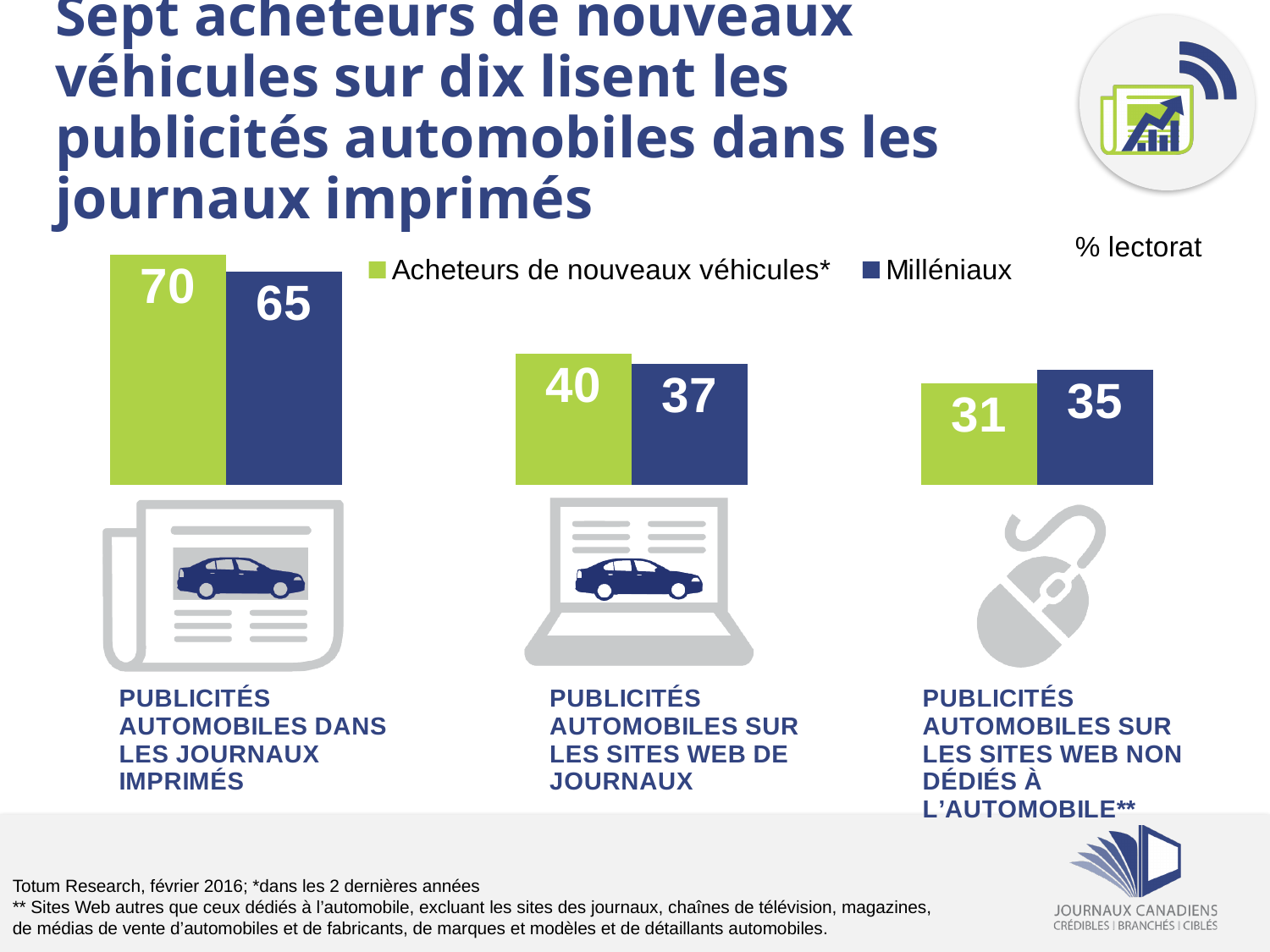
What unit label is shown above the chart? % lectorat How many categories are shown in the chart? 3 What is the difference between Milléniaux and Acheteurs de nouveaux véhicules for publicités automobiles sur les sites web non dédiés à l'automobile? 4 What is the value for Acheteurs de nouveaux véhicules for publicités automobiles dans les journaux imprimés? 70 What is the difference between Acheteurs de nouveaux véhicules and Milléniaux for publicités automobiles dans les journaux imprimés? 5 Which category has the lowest value for Acheteurs de nouveaux véhicules? Publicités automobiles sur les sites web non dédiés à l'automobile For publicités automobiles sur les sites web de journaux, which is larger: Acheteurs de nouveaux véhicules or Milléniaux? Acheteurs de nouveaux véhicules Which category has the highest value for Milléniaux? Publicités automobiles dans les journaux imprimés What is the value for Acheteurs de nouveaux véhicules for publicités automobiles sur les sites web non dédiés à l'automobile? 31 What is the value for Milléniaux for publicités automobiles sur les sites web de journaux? 37 What kind of chart is shown on the slide? Bar chart How many series does the legend list? 2